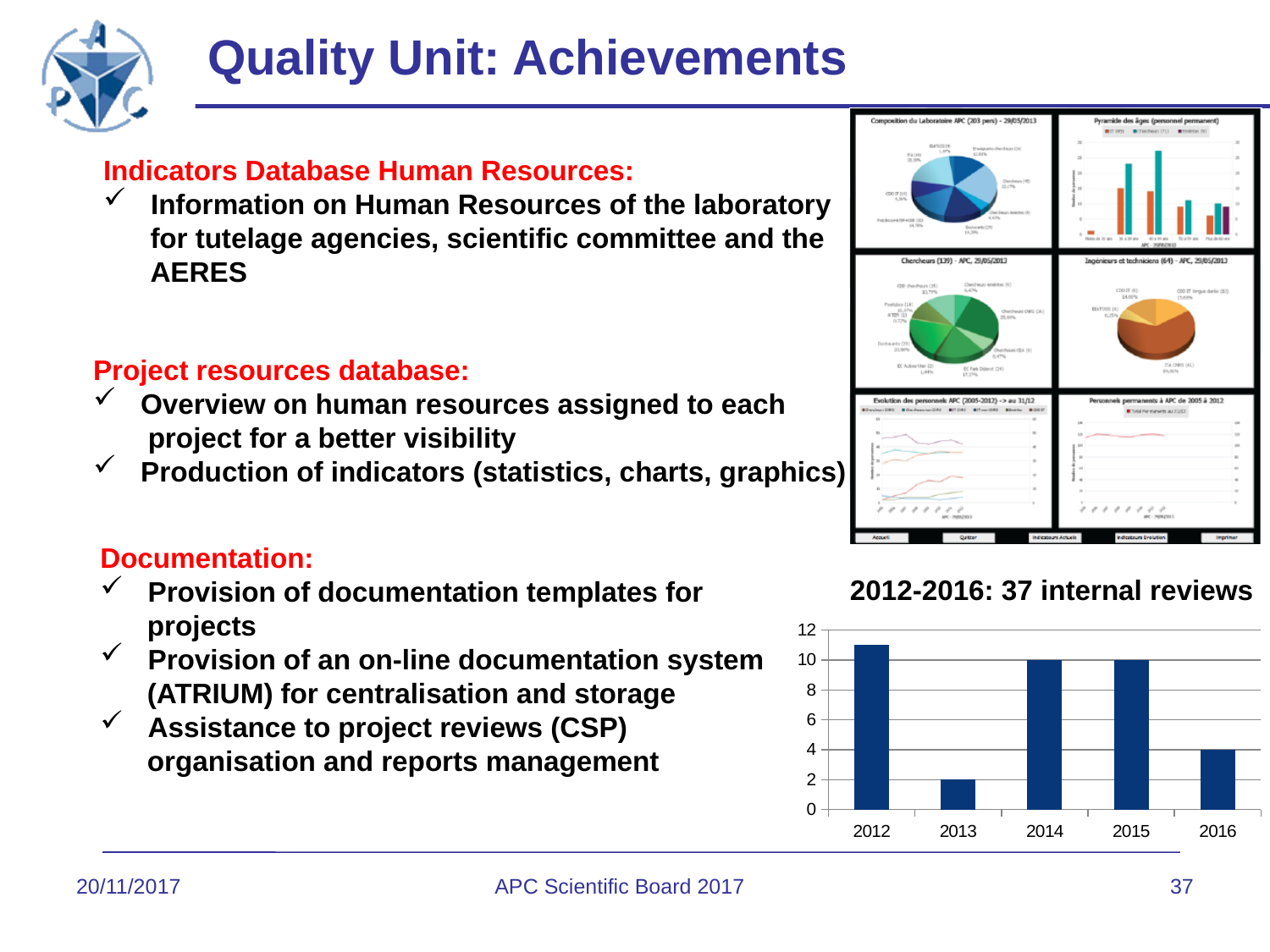
In the '2012-2016: 37 internal reviews' chart, is the value for 2012 greater or less than 10? greater In the '2012-2016: 37 internal reviews' chart, what is the difference between the values for 2016 and 2013? 2 In the '2012-2016: 37 internal reviews' chart, what is the difference between the values for 2014 and 2013? 8 Which year has the highest value in the '2012-2016: 37 internal reviews' chart? 2012 What is the value for 2014 in the '2012-2016: 37 internal reviews' chart? 10 What is the value for 2016 in the '2012-2016: 37 internal reviews' chart? 4 What kind of chart is the '2012-2016: 37 internal reviews' chart? bar chart In the '2012-2016: 37 internal reviews' chart, which is larger, the value for 2014 or the value for 2016? 2014 Which year has the lowest value in the '2012-2016: 37 internal reviews' chart? 2013 What is the value for 2013 in the '2012-2016: 37 internal reviews' chart? 2 How many years are shown on the x axis of the '2012-2016: 37 internal reviews' chart? 5 According to the title of the bar chart at the bottom right, how many internal reviews were there in 2012-2016? 37